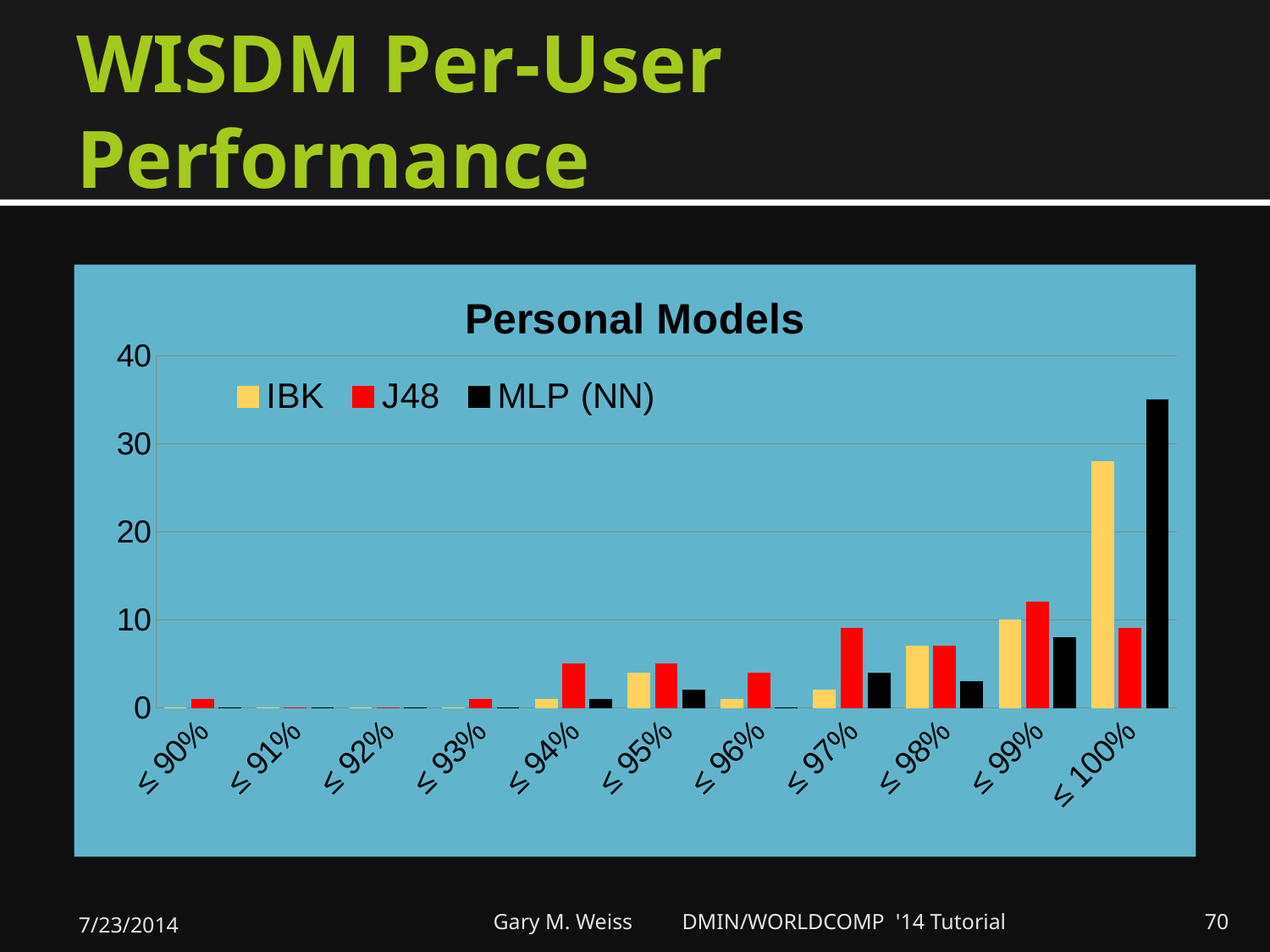
What kind of chart is shown on the slide? bar chart Is the value for J48 at ≤ 100% greater or less than 20? less Is the value for IBK at ≤ 100% greater or less than 20? greater What is the title of the chart? Personal Models At ≤ 97%, which is larger, the IBK bar or the J48 bar? J48 In which category is the MLP (NN) bar the highest? ≤ 100% Is the value for MLP (NN) at ≤ 100% greater or less than 30? greater Which series has the tallest bar in the ≤ 100% category? MLP (NN) At ≤ 99%, which is larger, the J48 bar or the MLP (NN) bar? J48 How many series does the legend list? 3 How many categories are shown on the x axis? 11